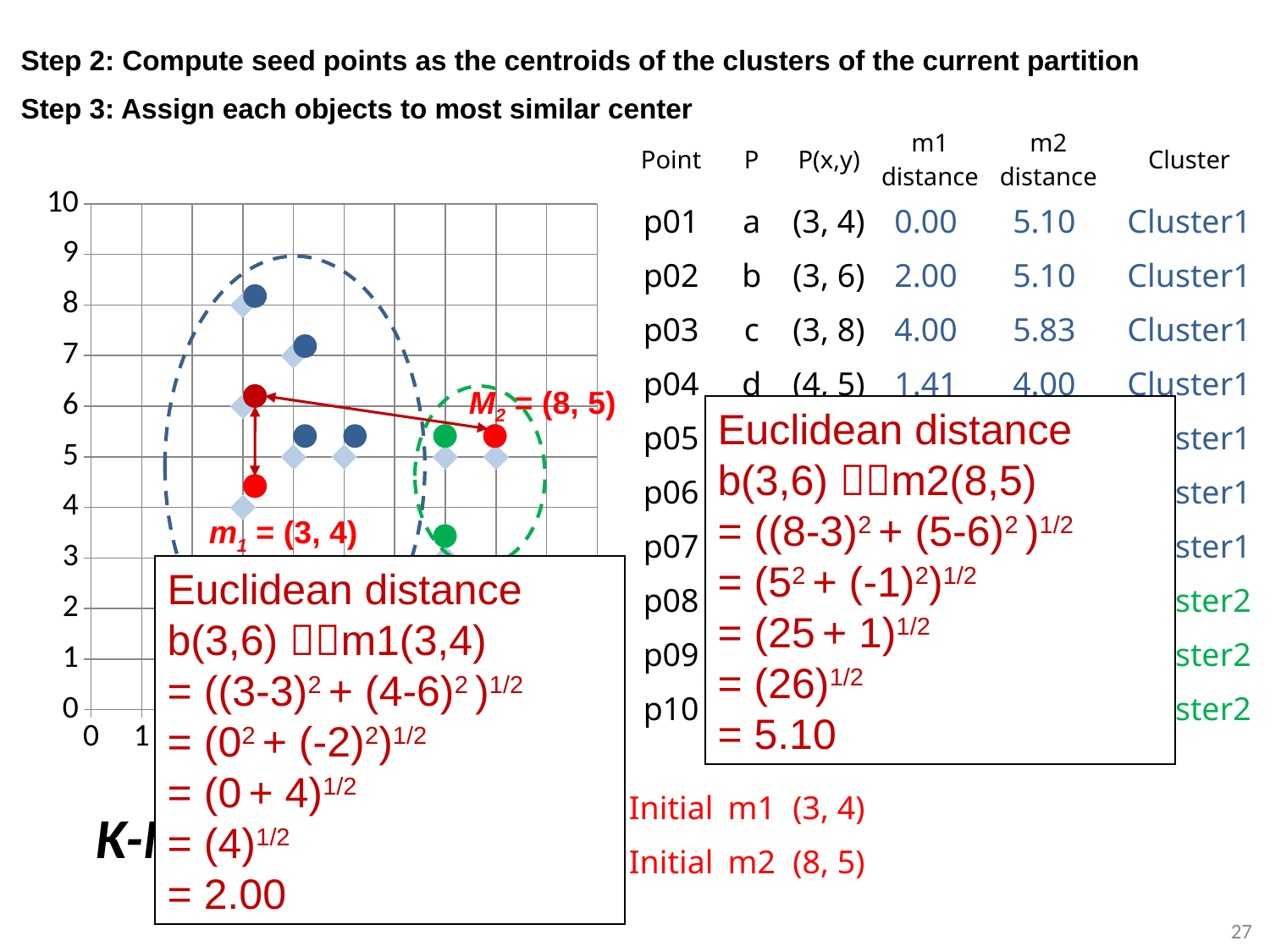
How many dashed cluster outlines are drawn on the chart? 2 How many blue points are plotted on the chart? 4 Is the y value of the seed point m1 greater or less than 5? less According to the table, what is the m2 distance for point c (3, 8)? 5.83 What are the coordinates of the seed point labelled m1 on the chart? (3, 4) According to the table, which cluster is point d (4, 5) assigned to? Cluster1 According to the table, what is the m1 distance for point b (3, 6)? 2.00 What is the highest value shown on the chart's y axis? 10 What kind of chart is shown on the left of the slide? scatter chart What are the coordinates of the seed point labelled M2 on the chart? (8, 5) Which seed point has the larger x coordinate, m1 or M2? M2 Is the x value of the seed point M2 greater or less than 5? greater